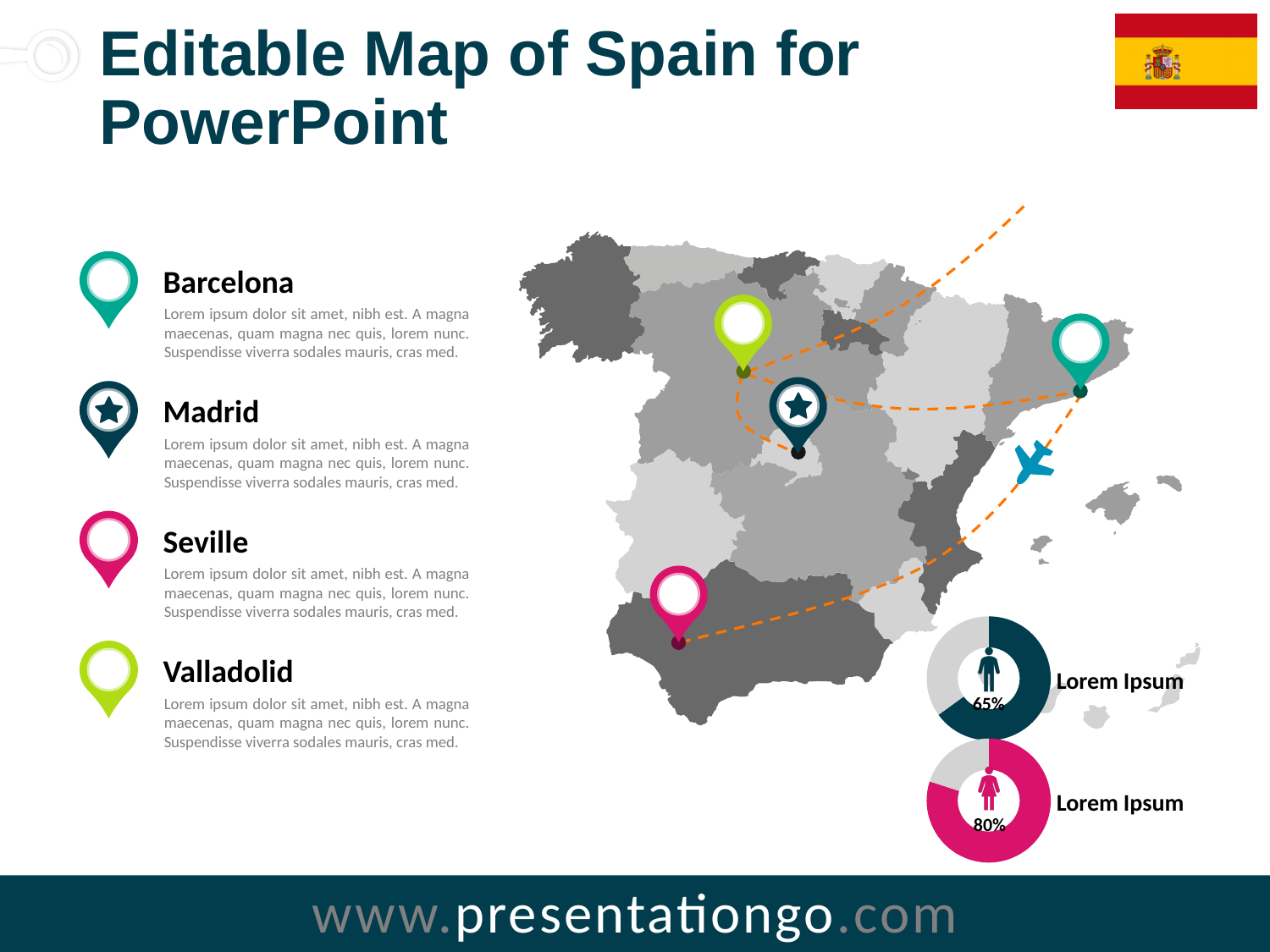
What colour is the filled portion of the lower donut chart with the female icon? pink What percentage is shown on the lower donut chart with the female figure icon? 80% What share of the lower donut chart (female icon) is filled with the pink colour? 80% What is the difference between the percentage on the lower donut chart (female icon) and the upper donut chart (male icon)? 15 percentage points What label text appears to the right of the upper donut chart with the male icon? Lorem Ipsum What percentage is shown on the upper donut chart with the male figure icon? 65% What kind of chart is used to display the 65% and 80% values on the slide? donut chart How many donut charts are shown on the slide? 2 Which of the two donut charts shows the larger percentage, the one with the male icon or the one with the female icon? the one with the female icon (80%) What share of the upper donut chart (male icon) is filled with the dark teal colour? 65%